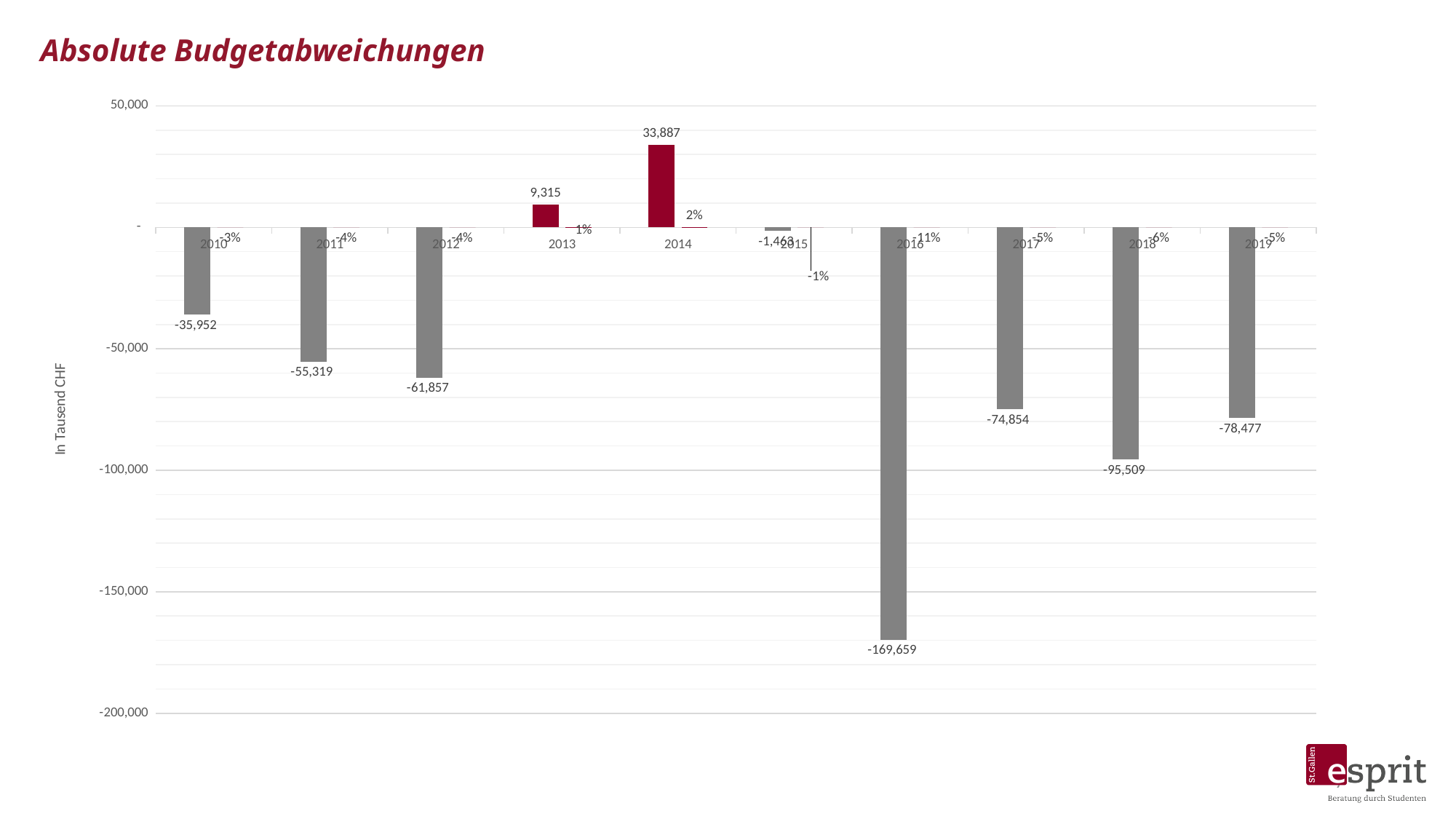
How many years are shown on the x axis? 10 What kind of chart is shown? bar chart What is the value for 2014? 33,887 What is the value for 2018? -95,509 Which year has the lowest value? 2016 What is the difference between the values for 2017 and 2019? 3,623 What is the value for 2013? 9,315 What is the label of the vertical axis? In Tausend CHF What is the value for 2016? -169,659 Is the value for 2018 greater or less than -100,000? greater Which year has the highest value? 2014 Which is larger, the value for 2011 or the value for 2012? 2011